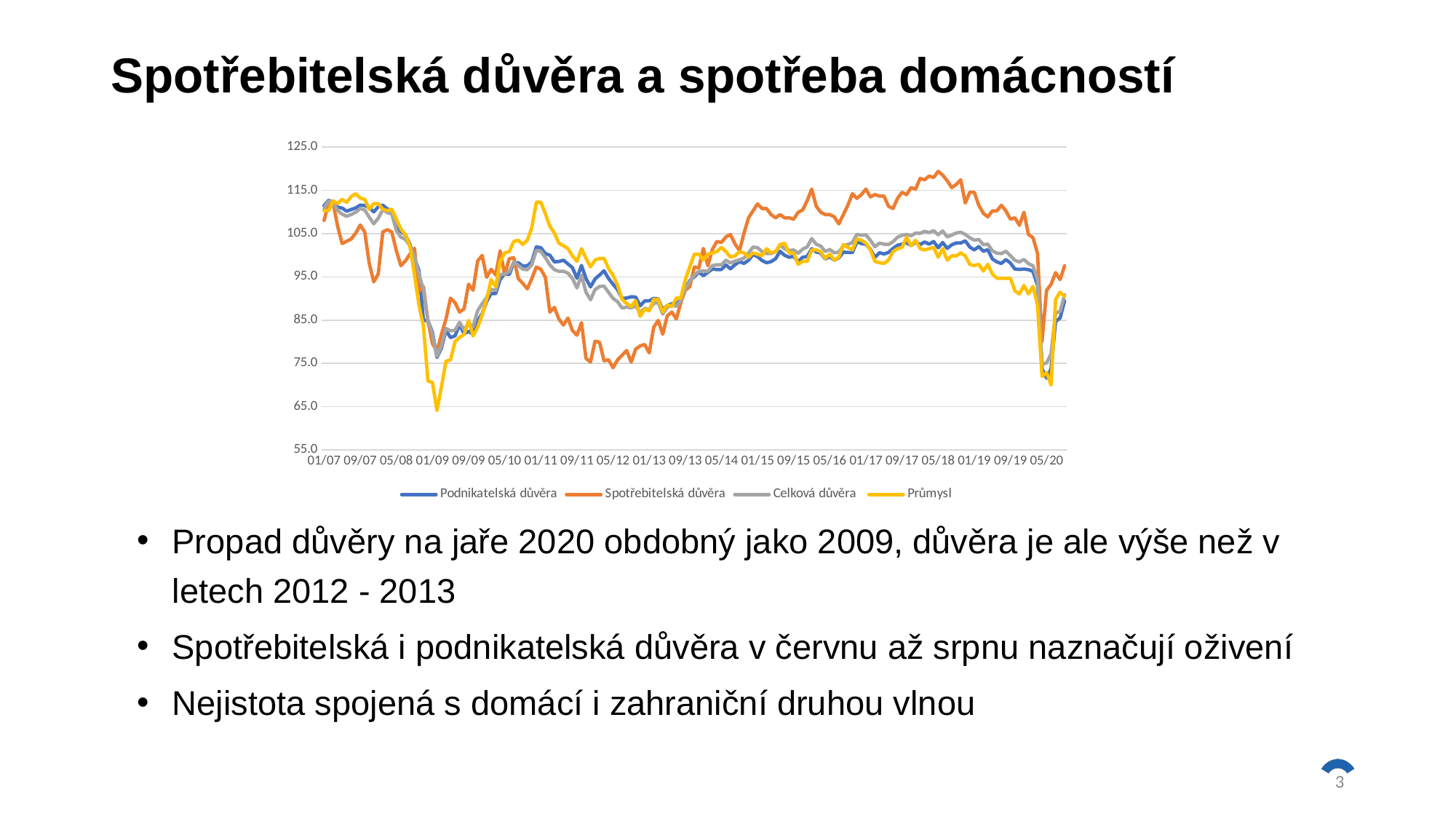
Is the peak value of Spotřebitelská důvěra around 05/18 greater or less than 115? greater What kind of chart is shown on the slide? line chart What is the highest value labelled on the vertical axis? 125.0 Does Spotřebitelská důvěra rise or fall between 05/12 and 05/18? rise How many date labels are shown on the horizontal axis? 21 Is the lowest value of Průmysl around 01/09 greater or less than 75? less How many series does the legend list? 4 Which series is drawn in orange? Spotřebitelská důvěra Is the value of Spotřebitelská důvěra around 05/12 greater or less than 85? less Around 01/15, which is higher: Spotřebitelská důvěra or Podnikatelská důvěra? Spotřebitelská důvěra Which series reaches the highest value anywhere on the chart? Spotřebitelská důvěra Which series reaches the lowest value anywhere on the chart? Průmysl